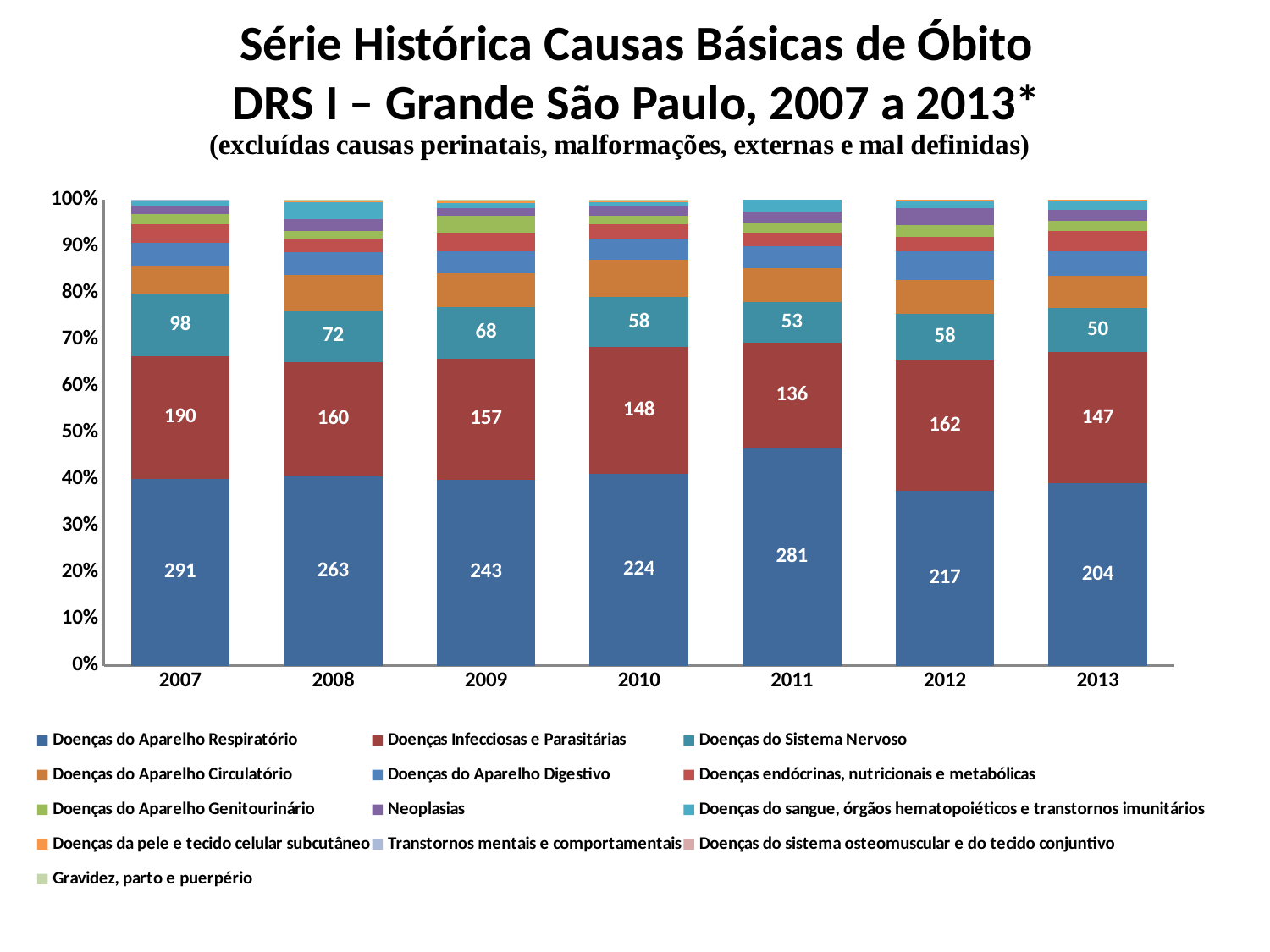
What is the value for Doenças do Sistema Nervoso in 2013? 50 In which year is the labelled value for Doenças do Aparelho Respiratório highest? 2007 Does the labelled value for Doenças do Sistema Nervoso rise or fall from 2007 to 2010? Fall What is the value for Doenças Infecciosas e Parasitárias in 2011? 136 How many years are shown on the x axis? 7 What kind of chart is shown on the slide? Stacked bar chart In which year is the labelled value for Doenças do Sistema Nervoso lowest? 2013 Which is larger: the Doenças Infecciosas e Parasitárias value in 2012 or in 2013? 2012 Which legend entry is shown in the dark blue colour at the bottom of each bar? Doenças do Aparelho Respiratório What is the value for Doenças do Aparelho Respiratório in 2007? 291 How many series does the legend list? 13 What is the difference between the Doenças do Aparelho Respiratório values for 2007 and 2013? 87